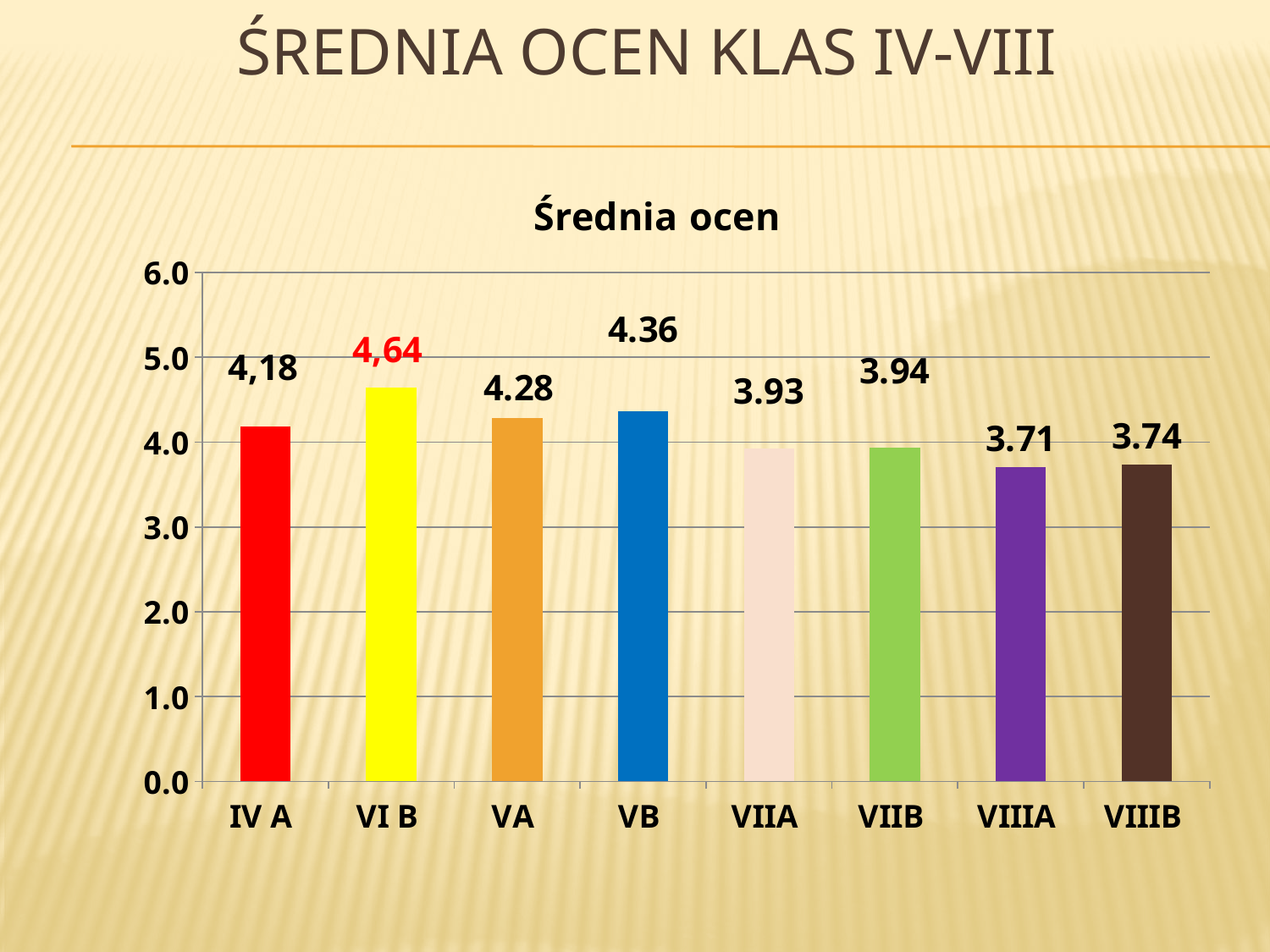
Which class has the lowest average grade? VIIIA Which is larger, the value for VA or the value for VB? VB Which class has the highest average grade? VI B Which class's data label is printed in red? VI B What is the value shown for VB? 4.36 What is the value shown for IV A? 4,18 What is the value shown for VIIIA? 3.71 What kind of chart is shown on the slide? bar chart How many classes are shown on the chart? 8 What is the title of the chart? Średnia ocen Is the value for VIIA greater or less than 4.0? less What is the difference between the values for VB and VA? 0.08